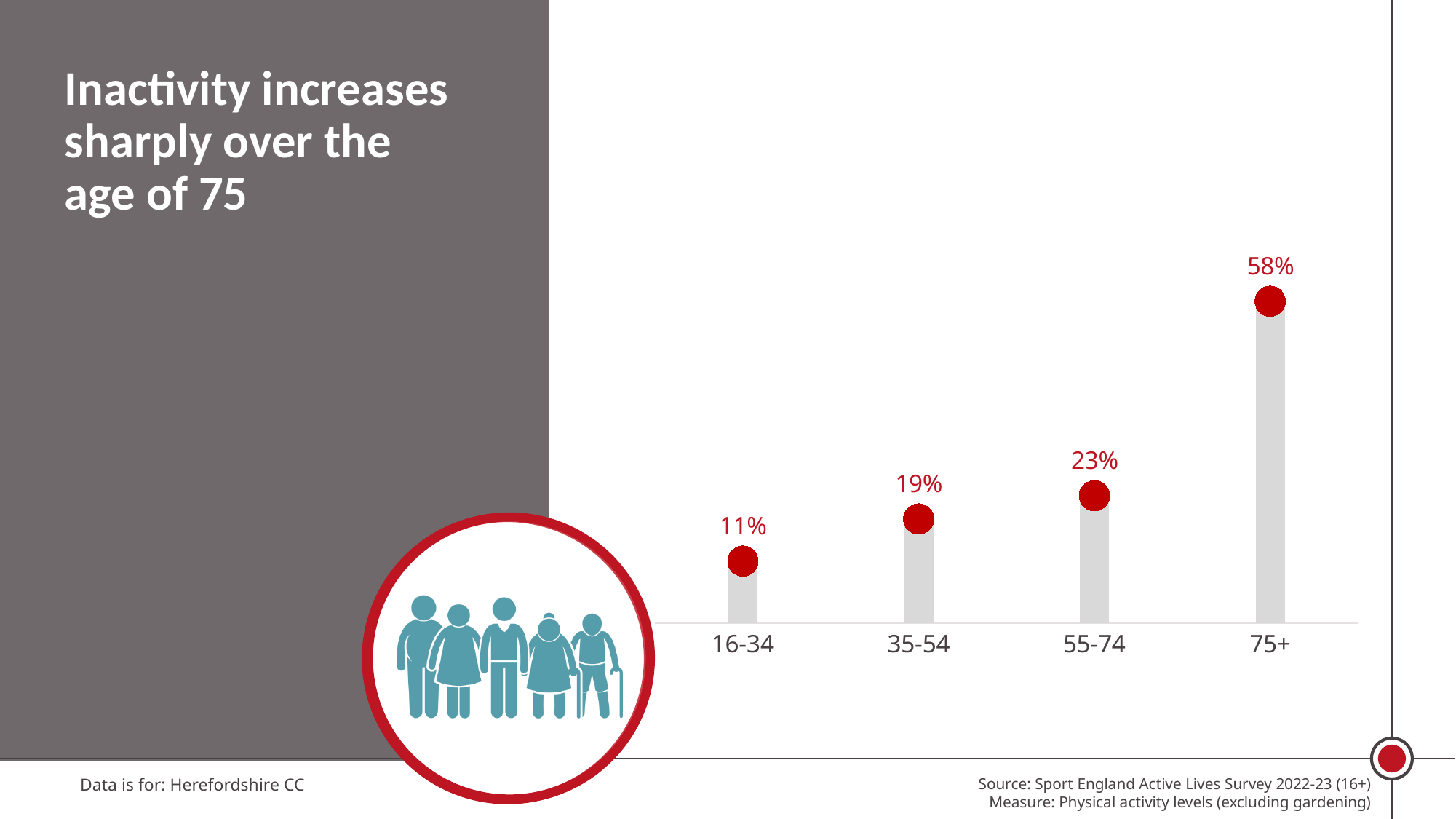
What is the inactivity value for the 16-34 age group? 11% Which has a larger inactivity value, the 35-54 or the 55-74 age group? 55-74 What is the inactivity value for the 75+ age group? 58% Which age group has the highest inactivity value? 75+ What kind of chart is shown on the slide? bar chart What is the difference between the inactivity values for the 75+ and 55-74 age groups? 35% What is the difference between the inactivity values for the 35-54 and 16-34 age groups? 8% Do the inactivity values rise or fall as age increases along the x axis? rise How many age groups are shown on the chart? 4 Which age group has the lowest inactivity value? 16-34 What is the inactivity value for the 55-74 age group? 23% What is the inactivity value for the 35-54 age group? 19%